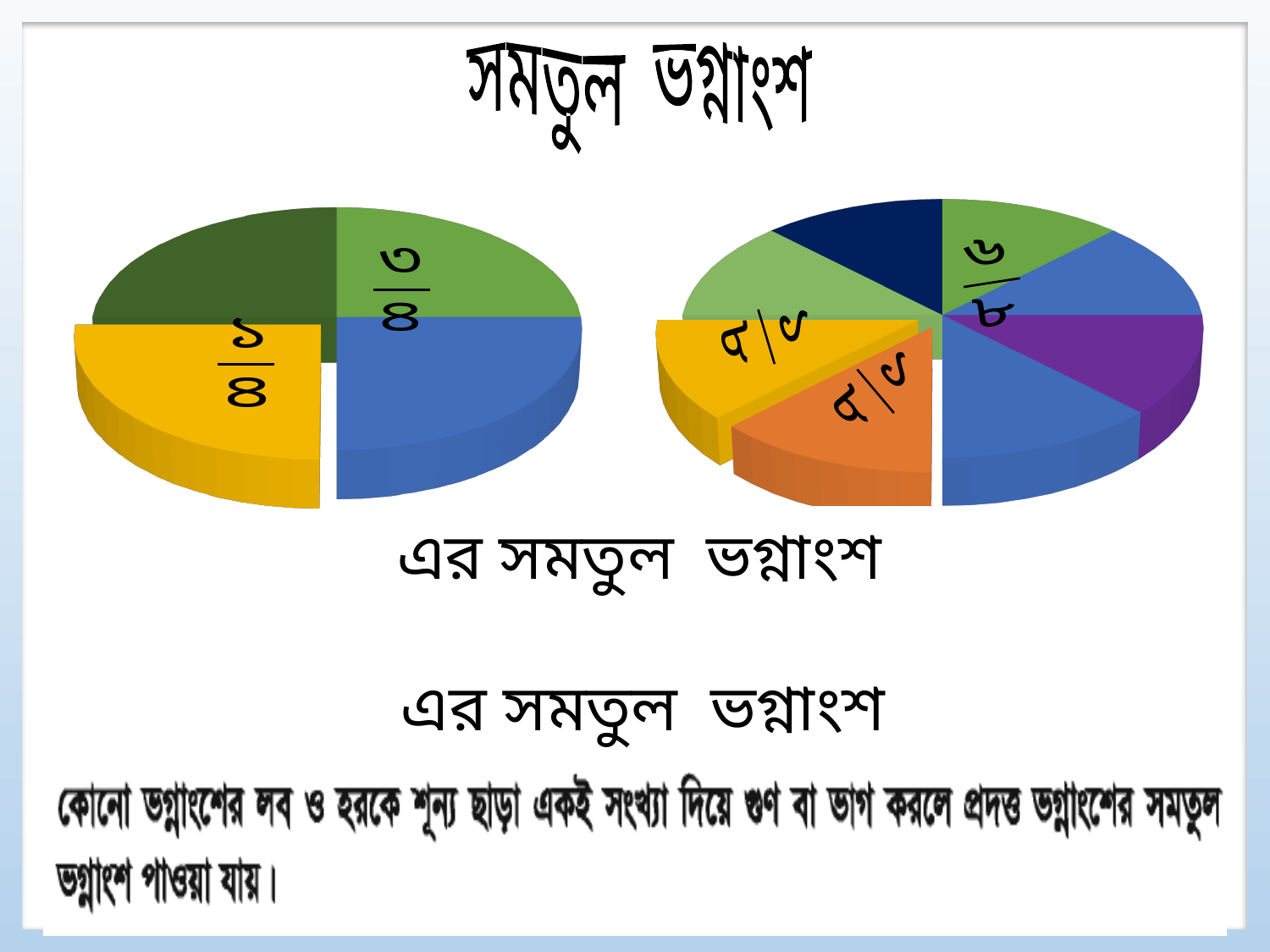
In the pie chart on the right, what fraction label is printed on the exploded yellow slice? ১/৮ In the pie chart on the left, what fraction label is printed on the group of three non-exploded slices? ৩/৪ What kind of chart is the chart on the left of the slide? pie chart In the pie chart on the right, what fraction label is printed on the exploded orange slice? ১/৮ What kind of chart is the chart on the right of the slide? pie chart How many slices are pulled out (exploded) from the pie chart on the right? 2 How many slices does the pie chart on the right have? 8 What colour is the exploded slice in the pie chart on the left? yellow In the pie chart on the left, which is larger: the part labelled ১/৪ or the part labelled ৩/৪? ৩/৪ How many slices does the pie chart on the left have? 4